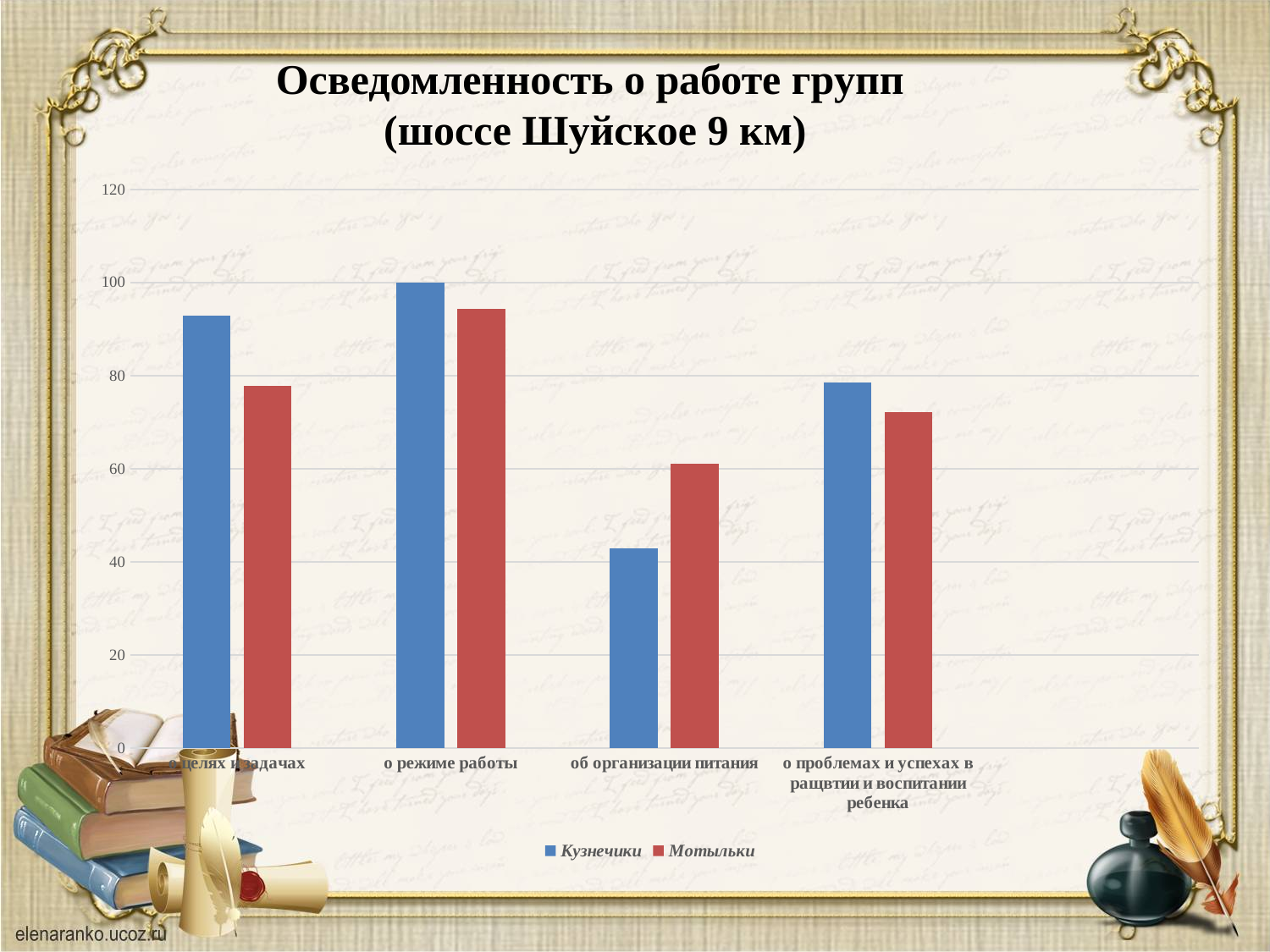
For which category is the Кузнечики value lowest? об организации питания Which colour represents the Мотыльки series in the chart? red In the category 'о целях и задачах', which series has the larger value, Кузнечики or Мотыльки? Кузнечики What is the value for Кузнечики in the category 'о режиме работы'? 100 For which category is the Мотыльки value lowest? об организации питания Is the value for Кузнечики in 'об организации питания' greater or less than 60? less For which category is the Кузнечики value highest? о режиме работы How many series does the legend list? 2 How many categories are shown on the x axis? 4 In the category 'об организации питания', which series has the larger value, Кузнечики or Мотыльки? Мотыльки For which category is the Мотыльки value highest? о режиме работы What kind of chart is shown on the slide? bar chart